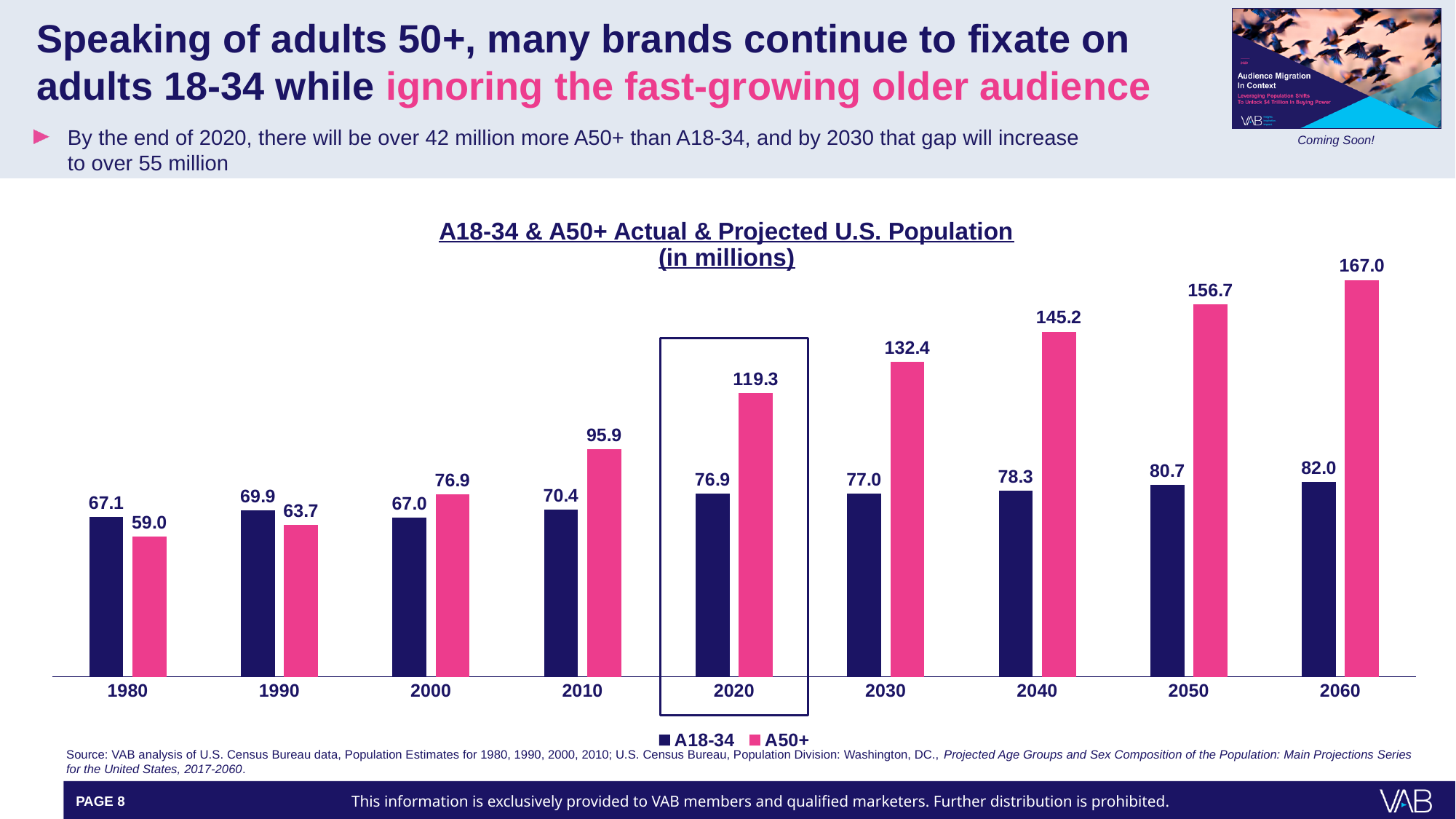
What type of chart is shown on the slide? Bar chart What is the A50+ population value for 2020? 119.3 Which year is highlighted with a box on the chart? 2020 What is the difference between the A50+ and A18-34 values in 2030? 55.4 What is the A18-34 population value for 1980? 67.1 How many years are shown on the x axis? 9 In which year is the A18-34 value the highest? 2060 Does the A50+ series rise or fall from 1980 to 2060? Rise In which year is the A50+ value the lowest? 1980 What is the A50+ population value for 2060? 167.0 How many series does the legend list? 2 Which is larger in 1990, the A18-34 value or the A50+ value? A18-34